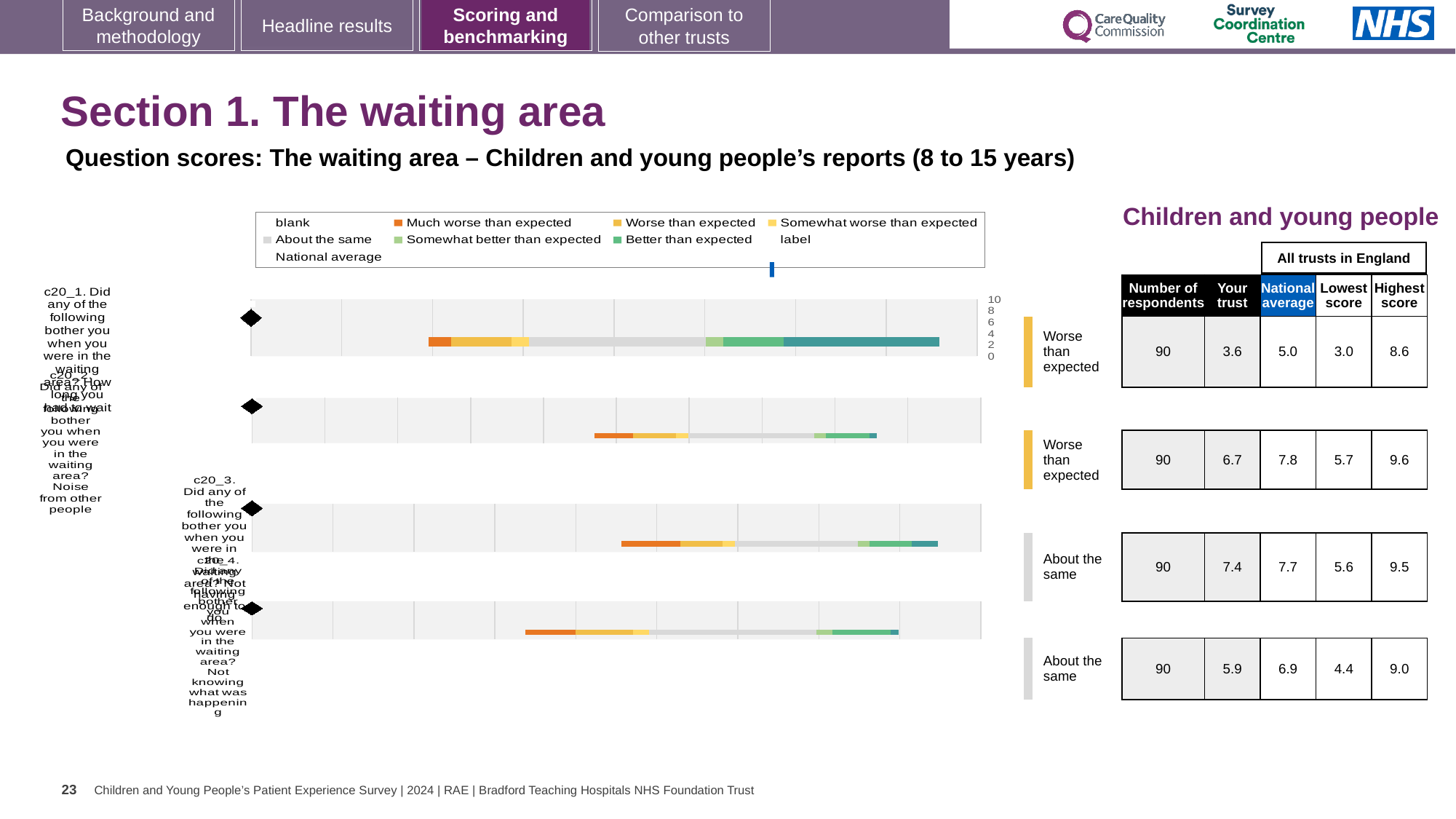
Which of the four questions has the lowest 'Your trust' score? c20_1 (how long you had to wait), 3.6 According to the table, what is the highest score in England for the second question (c20_2, noise from other people)? 9.6 For the fourth question (c20_4, not knowing what was happening), is the 'Your trust' score (5.9) higher or lower than the national average (6.9)? lower In the chart legend, which colour represents 'Much worse than expected'? orange In the chart legend, which colour represents 'About the same'? grey How many questions (bars) are plotted in the chart? 4 According to the table, what is the national average for the first question (c20_1)? 5.0 According to the table, what is the 'Your trust' score for the first question (c20_1, how long you had to wait)? 3.6 Which of the four questions has the highest 'Your trust' score? c20_3 (not having enough to do), 7.4 What type of chart is used to show the question scores on this slide? bar chart What is the difference between the highest score (8.6) and the lowest score (3.0) for the first question (c20_1)? 5.6 How many respondents answered each of the four waiting area questions? 90